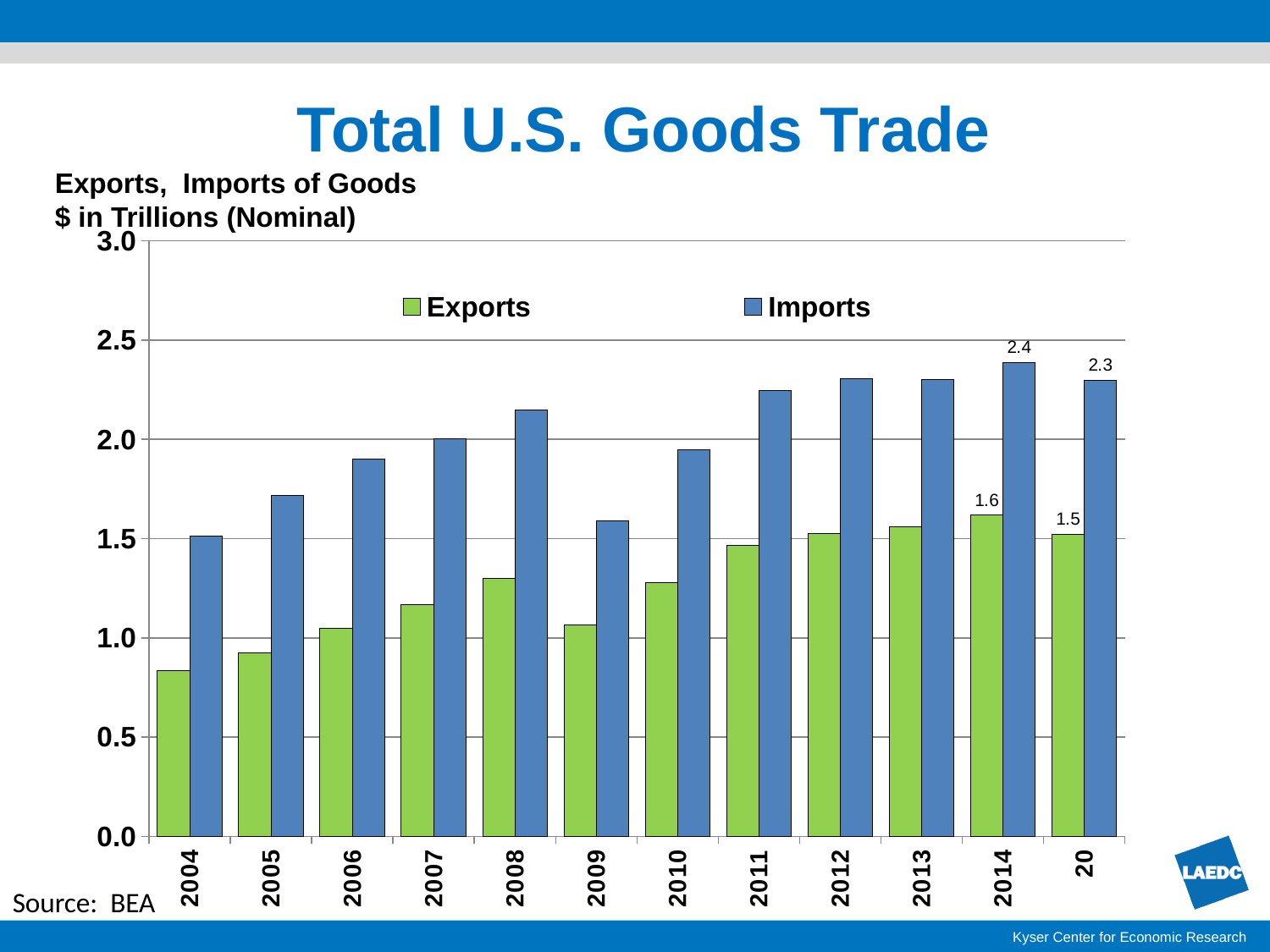
How many series does the legend list? 2 Is the value for Exports in 2010 greater or less than 1.5? less What kind of chart is shown on the slide? bar chart Is the value for Exports in 2004 greater or less than 1.0? less What is the difference between Imports and Exports in 2014? 0.8 Is the value for Imports in 2008 greater or less than 2.0? greater In 2014, which is larger, Exports or Imports? Imports Which year has the highest Imports value? 2014 Which year has the lowest Exports value? 2004 What is the value for Imports in 2014? 2.4 What is the value for Exports in 2014? 1.6 Do Exports rise or fall from 2004 to 2008? rise